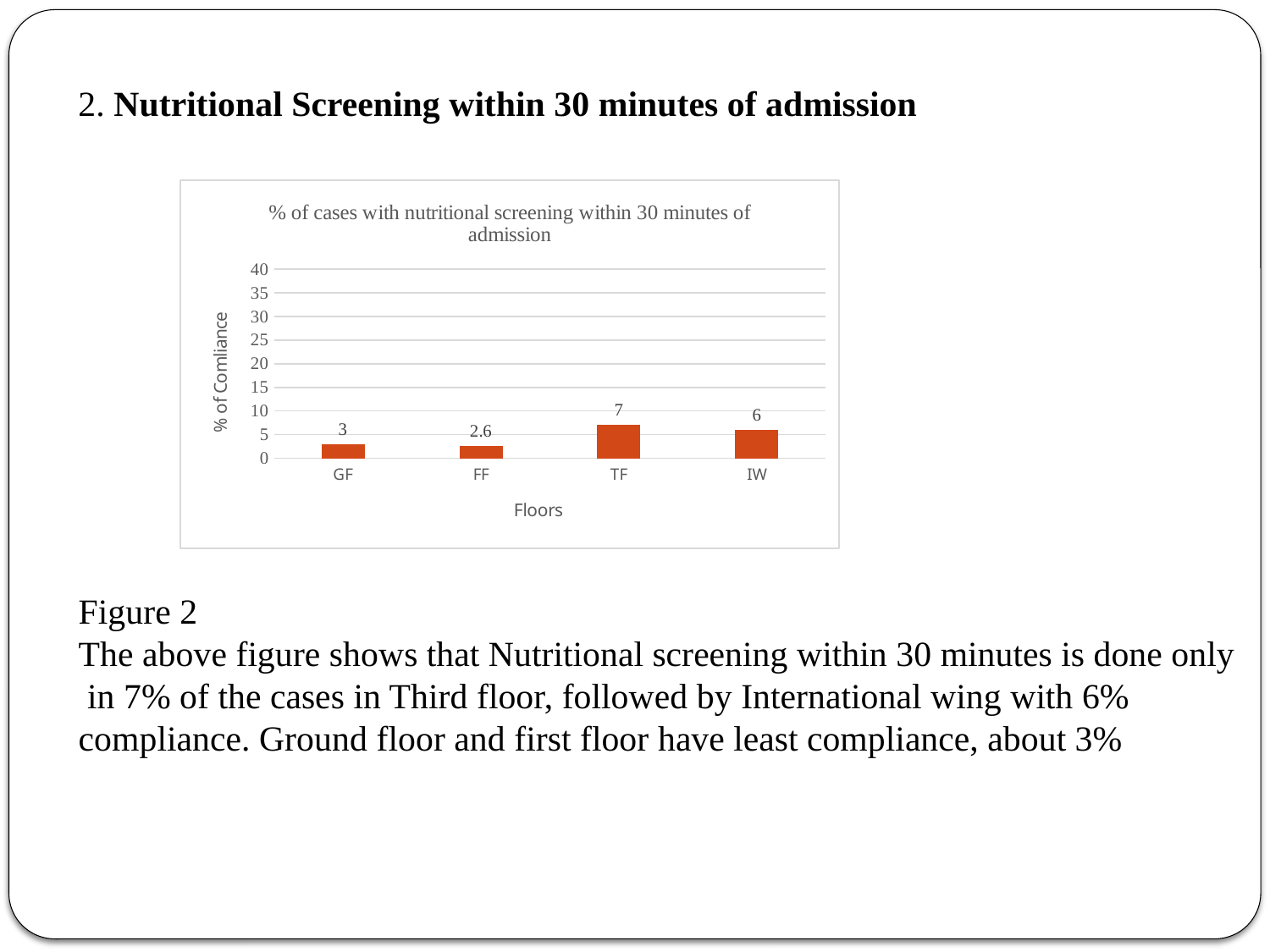
Which floor has the lowest value? FF How many floors are shown on the x axis? 4 What kind of chart is shown? bar chart What is the difference between the values for TF and IW? 1 What is the difference between the values for GF and FF? 0.4 What is the value for IW? 6 What is the value for GF? 3 What is the value for FF? 2.6 Which floor has the highest value? TF Is the value for TF greater or less than 10? less What is the value for TF? 7 Which is larger, the value for GF or the value for IW? IW